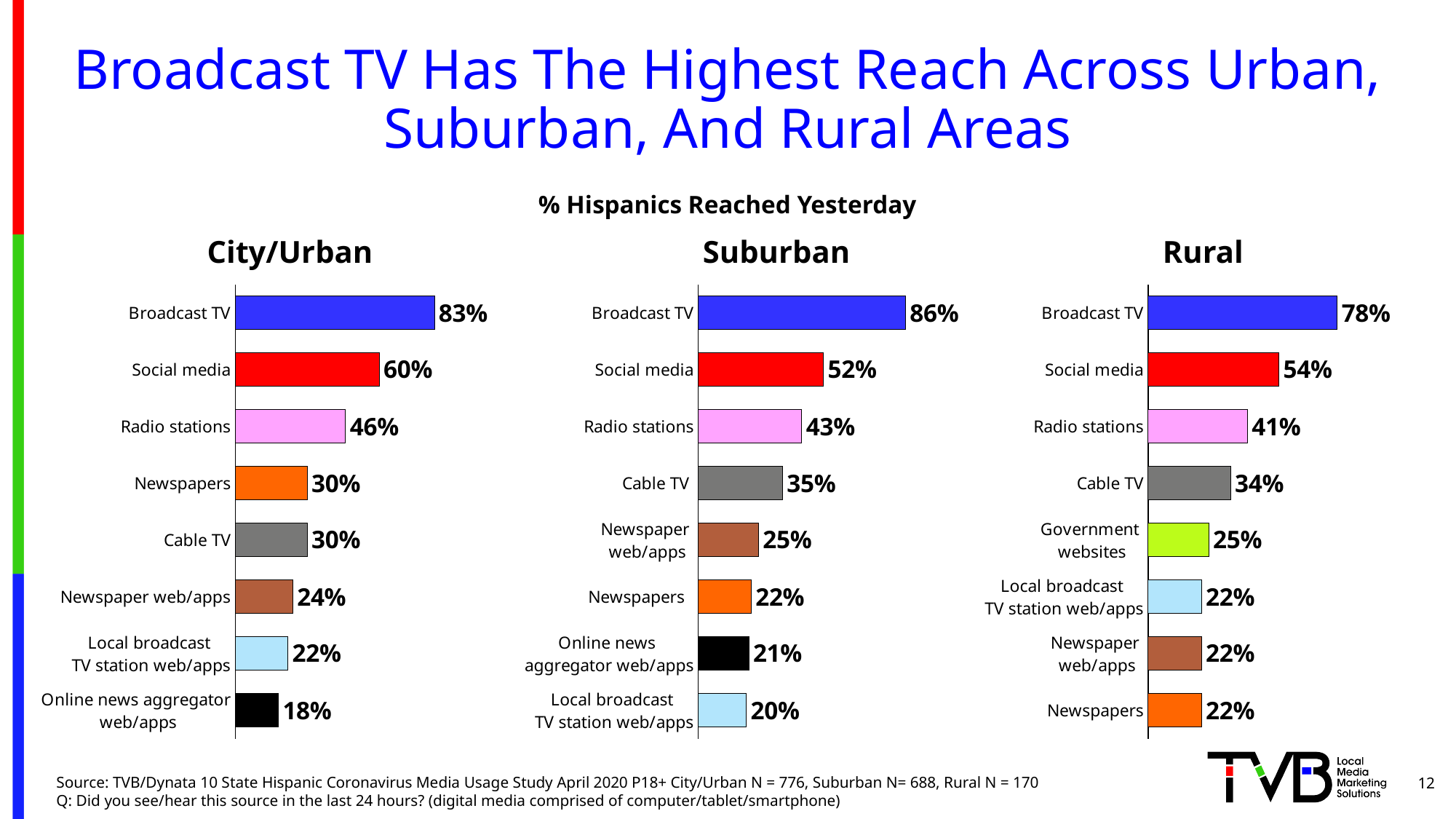
In the Rural chart, what is the value for Government websites? 25% What kind of chart is the City/Urban chart? Bar chart In the City/Urban chart, what is the difference between Radio stations and Newspapers? 16% In the Suburban chart, what is the value for Cable TV? 35% In the Suburban chart, which category has the lowest value? Local broadcast TV station web/apps In the City/Urban chart, which category has the lowest value? Online news aggregator web/apps In the Suburban chart, which category has the highest value? Broadcast TV What is the shared subtitle above the three charts? % Hispanics Reached Yesterday Which is larger: Broadcast TV in the Suburban chart or Broadcast TV in the Rural chart? Suburban How many categories are shown in the Rural chart? 8 In the City/Urban chart, what is the value for Social media? 60% In the Rural chart, what is the difference between Broadcast TV and Social media? 24%